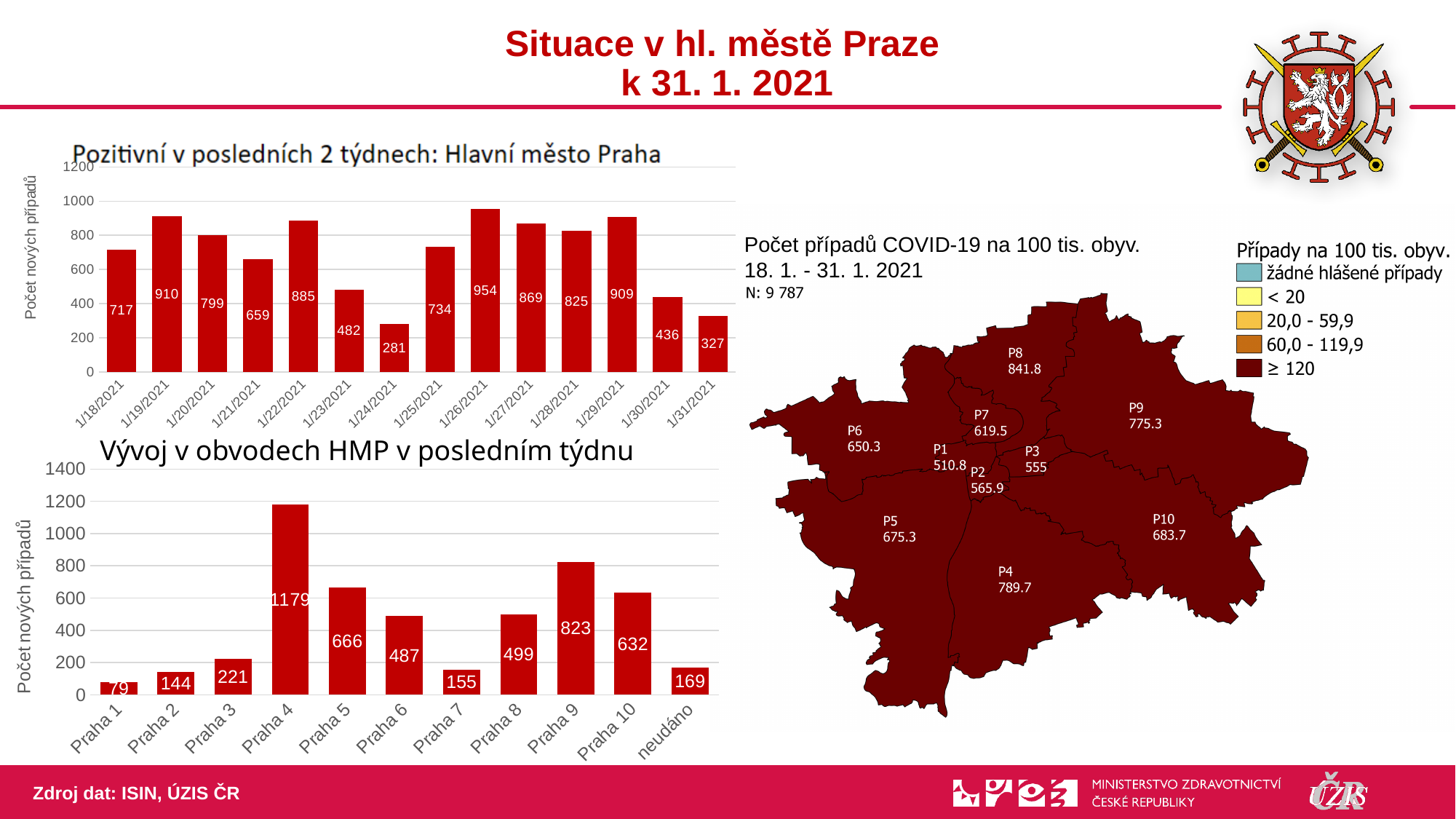
In the chart 'Pozitivní v posledních 2 týdnech: Hlavní město Praha', which date has the lowest value? 1/24/2021 In the chart 'Vývoj v obvodech HMP v posledním týdnu', what is the value for Praha 9? 823 In the chart 'Vývoj v obvodech HMP v posledním týdnu', how many categories are shown on the x axis? 11 In the chart 'Pozitivní v posledních 2 týdnech: Hlavní město Praha', what is the value for 1/26/2021? 954 In the chart 'Vývoj v obvodech HMP v posledním týdnu', which category has the lowest value? Praha 1 In the chart 'Pozitivní v posledních 2 týdnech: Hlavní město Praha', which date has the highest value? 1/26/2021 What kind of chart is 'Vývoj v obvodech HMP v posledním týdnu'? bar chart In the chart 'Vývoj v obvodech HMP v posledním týdnu', which is larger, the value for Praha 5 or Praha 10? Praha 5 In the chart 'Vývoj v obvodech HMP v posledním týdnu', which category has the highest value? Praha 4 In the chart 'Pozitivní v posledních 2 týdnech: Hlavní město Praha', is the value for 1/30/2021 greater or less than 400? greater In the chart 'Pozitivní v posledních 2 týdnech: Hlavní město Praha', what is the difference between the values for 1/19/2021 and 1/18/2021? 193 In the chart 'Pozitivní v posledních 2 týdnech: Hlavní město Praha', how many dates are shown on the x axis? 14